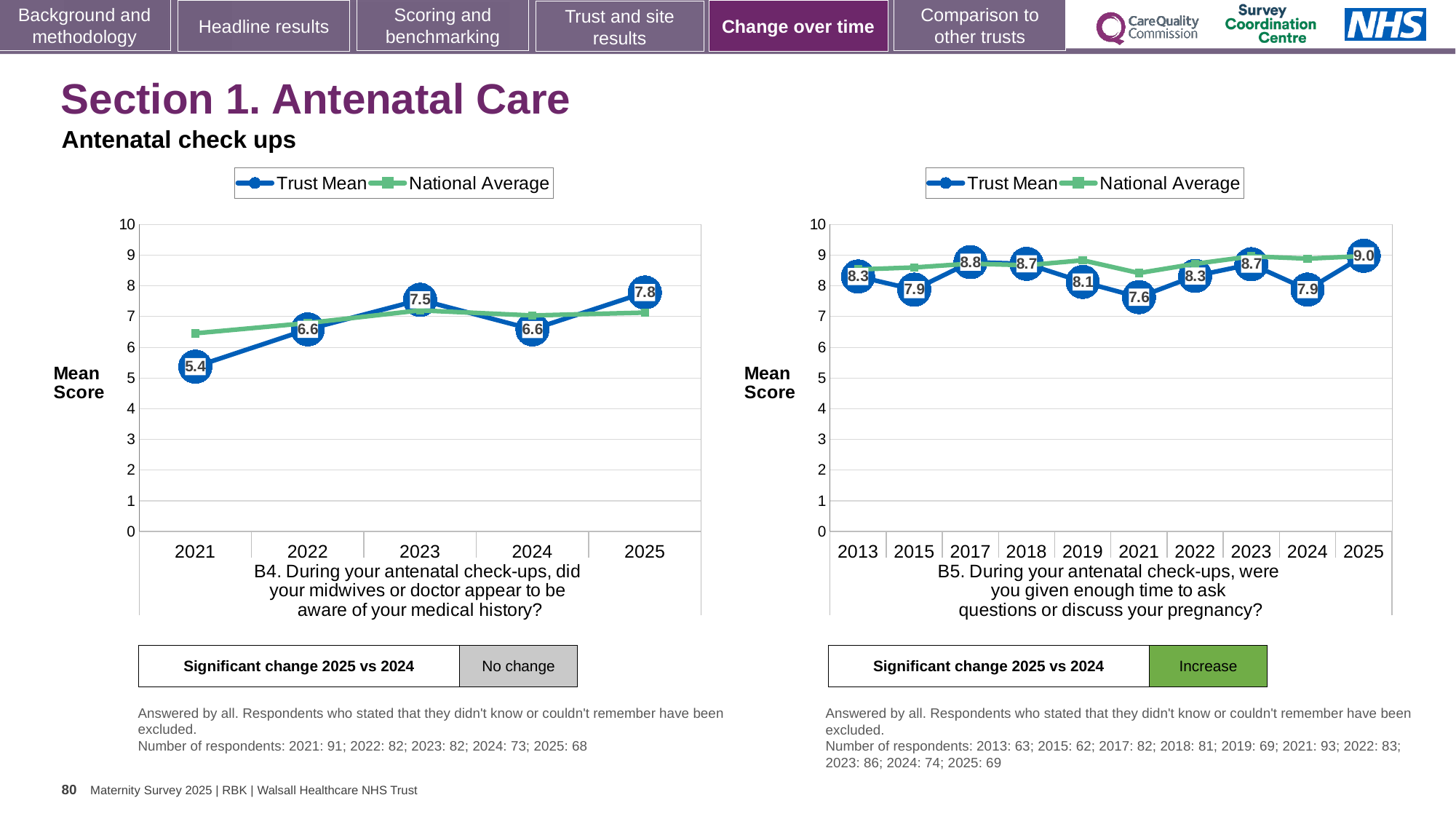
In the left chart (B4), is the National Average value for 2021 greater or less than 6? greater In the left chart (B4), what is the Trust Mean score for 2025? 7.8 In the left chart (B4), what is the Trust Mean score for 2021? 5.4 What type of chart is used for the left chart (B4)? Line chart In the right chart (B5), is the Trust Mean score for 2017 larger or smaller than the score for 2019? larger In the right chart (B5), which year has the highest Trust Mean score? 2025 In the left chart (B4), how many years are shown on the x axis? 5 In the left chart (B4), what is the difference between the Trust Mean scores for 2025 and 2021? 2.4 In the right chart (B5), what is the Trust Mean score for 2021? 7.6 In the left chart (B4), which year has the lowest Trust Mean score? 2021 How many series does the legend of the right chart (B5) list? 2 In the right chart (B5), how many years are shown on the x axis? 10